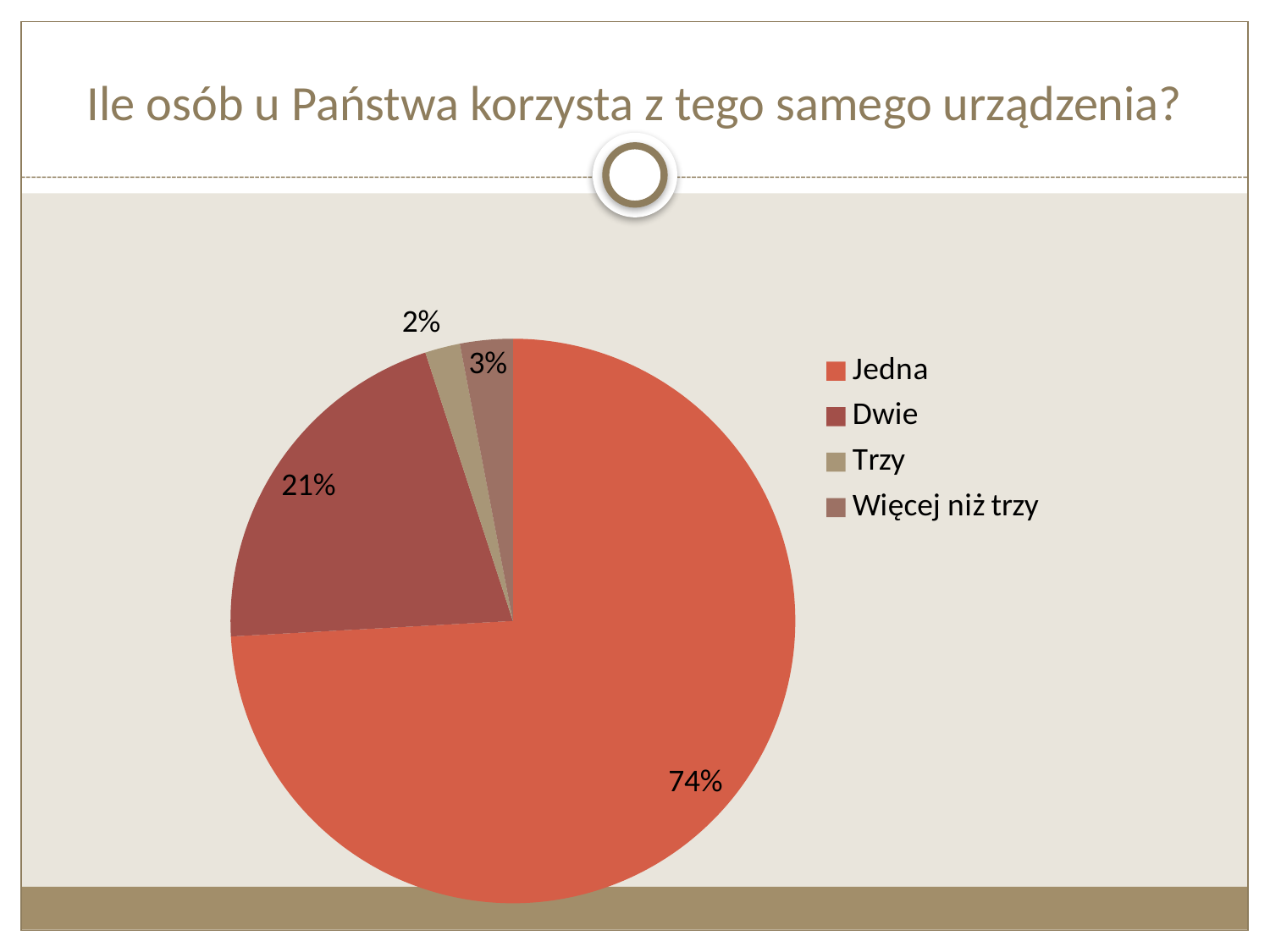
Which is larger, the slice for "Dwie" or the slice for "Więcej niż trzy"? Dwie What is the value shown for "Trzy"? 2% What is the title of the slide containing the chart? Ile osób u Państwa korzysta z tego samego urządzenia? Which legend entry is listed last? Więcej niż trzy What is the value shown for "Więcej niż trzy"? 3% What share of the pie does the "Jedna" slice represent? 74% What is the value shown for "Dwie"? 21% Which category has the largest slice of the pie? Jedna What is the difference in percentage points between "Jedna" and "Dwie"? 53 How many categories does the pie chart show? 4 Which category has the smallest slice of the pie? Trzy What type of chart is shown on the slide? Pie chart